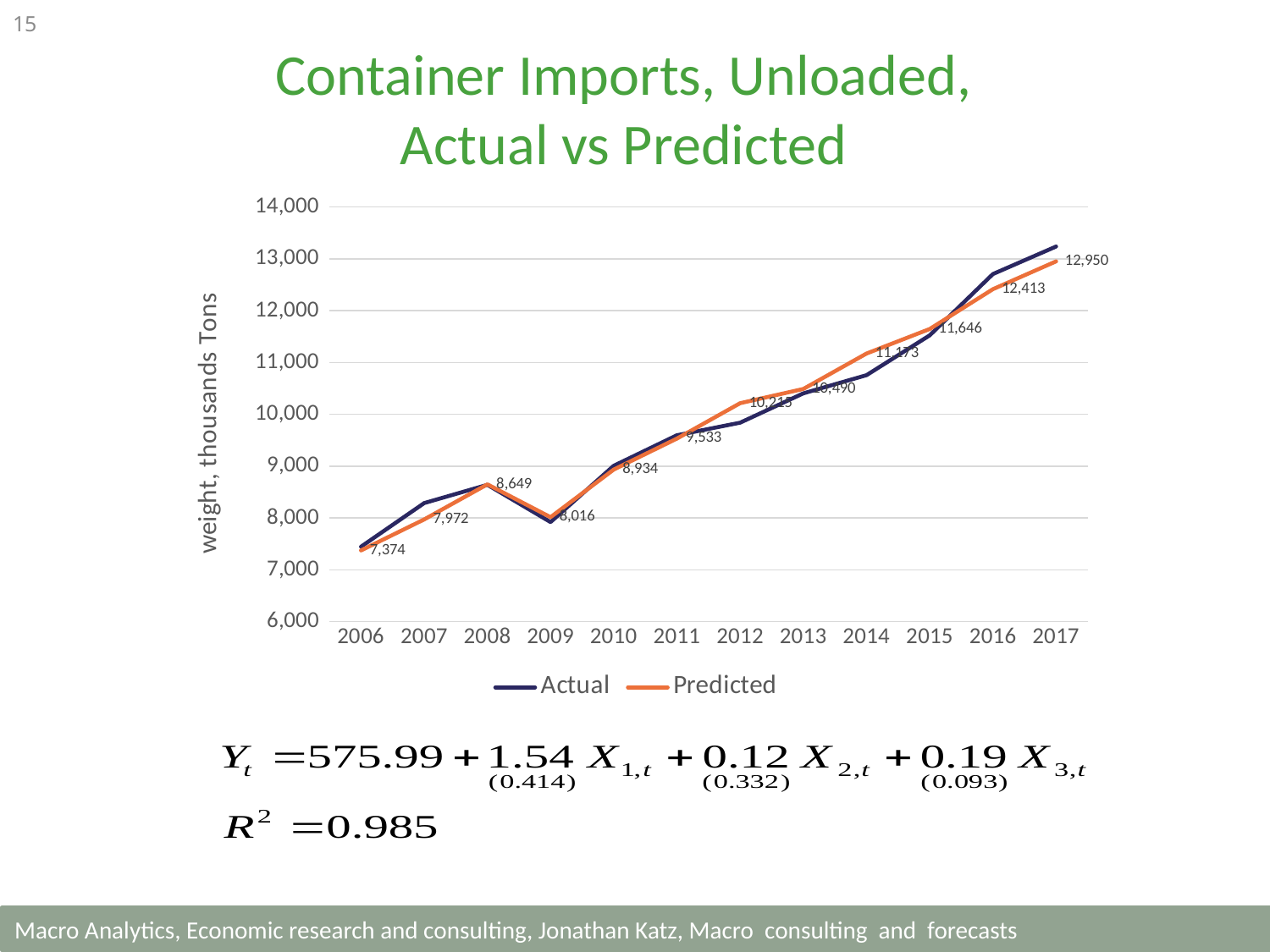
What is the Predicted value for 2017? 12,950 What is the difference between the Predicted values for 2017 and 2006? 5,576 What is the Predicted value for 2009? 8,016 What is the Predicted value for 2006? 7,374 Which year has the highest Predicted value? 2017 What is the title of the y axis? weight, thousands Tons Is the Actual value for 2017 greater or less than 13,000? greater How many years are plotted along the x axis? 12 Which year has the lowest Predicted value? 2006 What kind of chart is shown on the slide? line chart What is the Predicted value for 2008? 8,649 How many series does the legend list? 2